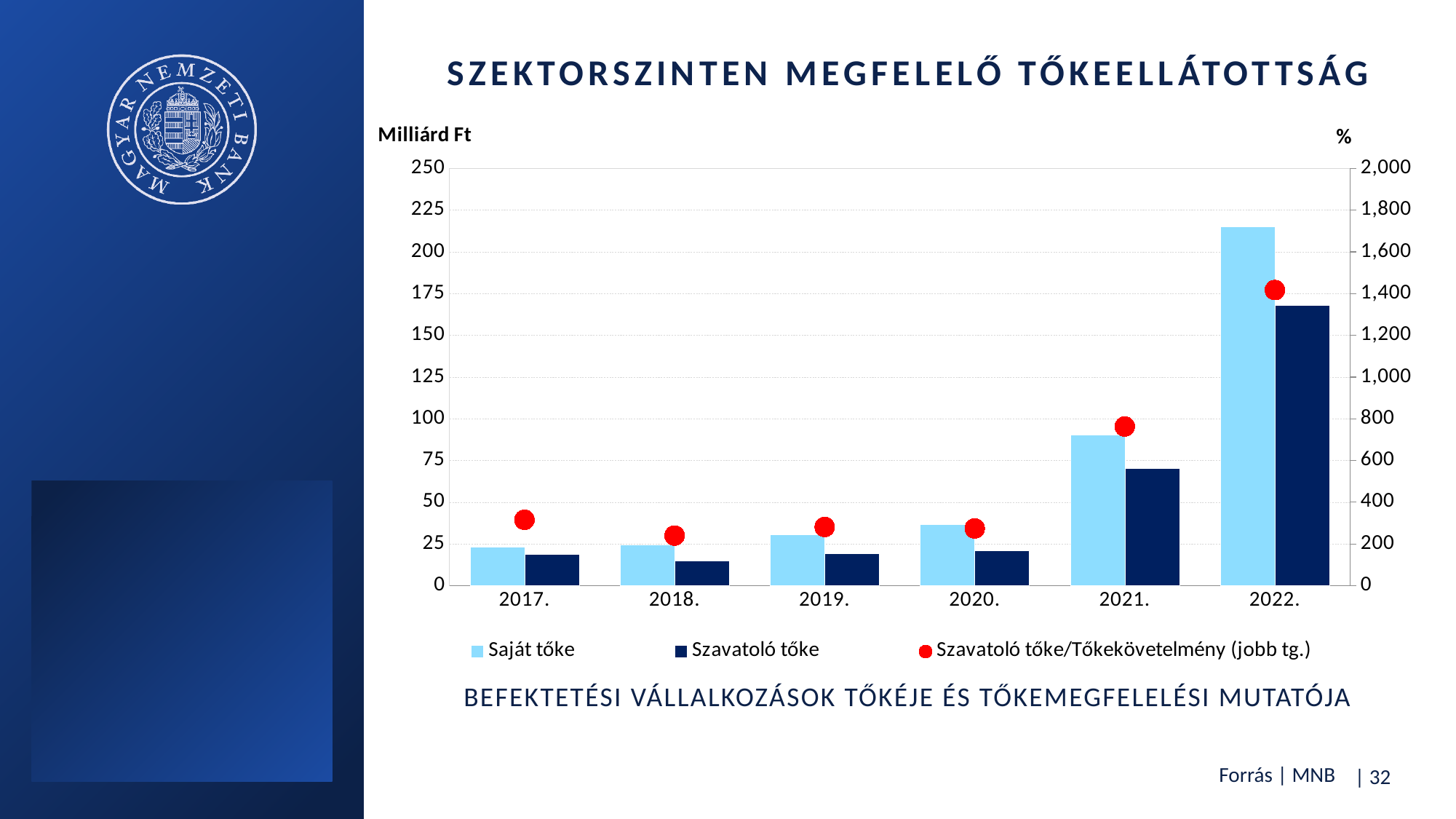
What kind of chart is shown on the slide? combination bar and line chart In which year is Saját tőke highest? 2022. In which year is the Szavatoló tőke/Tőkekövetelmény ratio highest? 2022. What unit is shown on the left axis of the chart? Milliárd Ft Is the value of Saját tőke for 2022. greater or less than 200? greater How many years are shown on the x axis of the chart? 6 Is the Szavatoló tőke/Tőkekövetelmény value for 2022. greater or less than 1,200 on the right axis? greater Is the value of Saját tőke for 2021. greater or less than 100? less How many series does the chart legend list? 3 In which year is Szavatoló tőke lowest? 2018. In 2021., which is larger: Saját tőke or Szavatoló tőke? Saját tőke Does Saját tőke rise or fall from 2017. to 2022.? rise